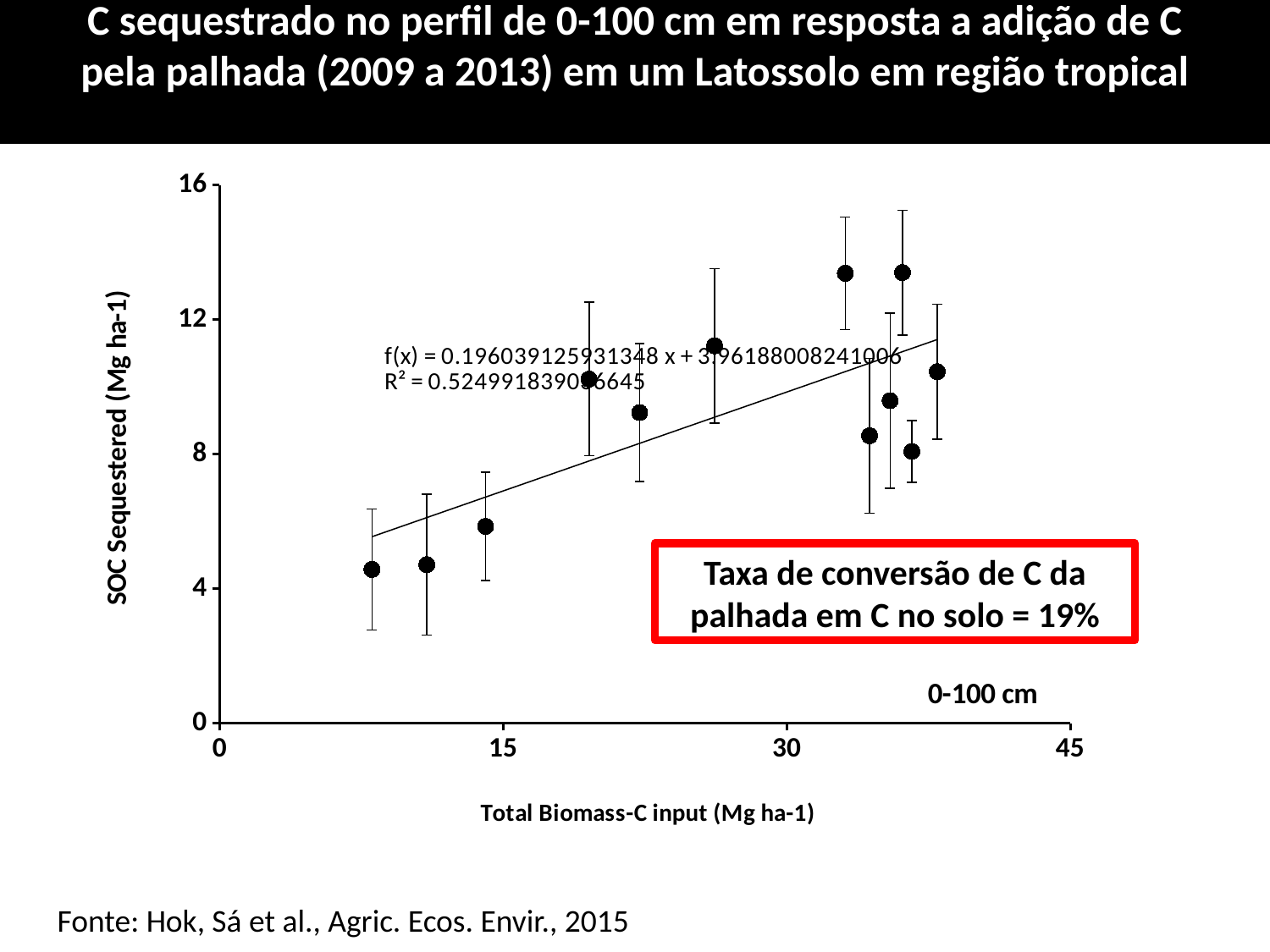
What R² value is printed on the chart? 0.524991839096645 How many data points are plotted on the chart? 12 Is the SOC Sequestered value of the lowest data point greater or less than 4? greater Is the SOC Sequestered value of the leftmost data point greater or less than 8? less What kind of chart is shown on the slide? scatter plot What is the highest value shown on the x axis? 45 Do the SOC Sequestered values generally rise or fall as Total Biomass-C input increases? rise Are any data points plotted above 16 on the y axis? No